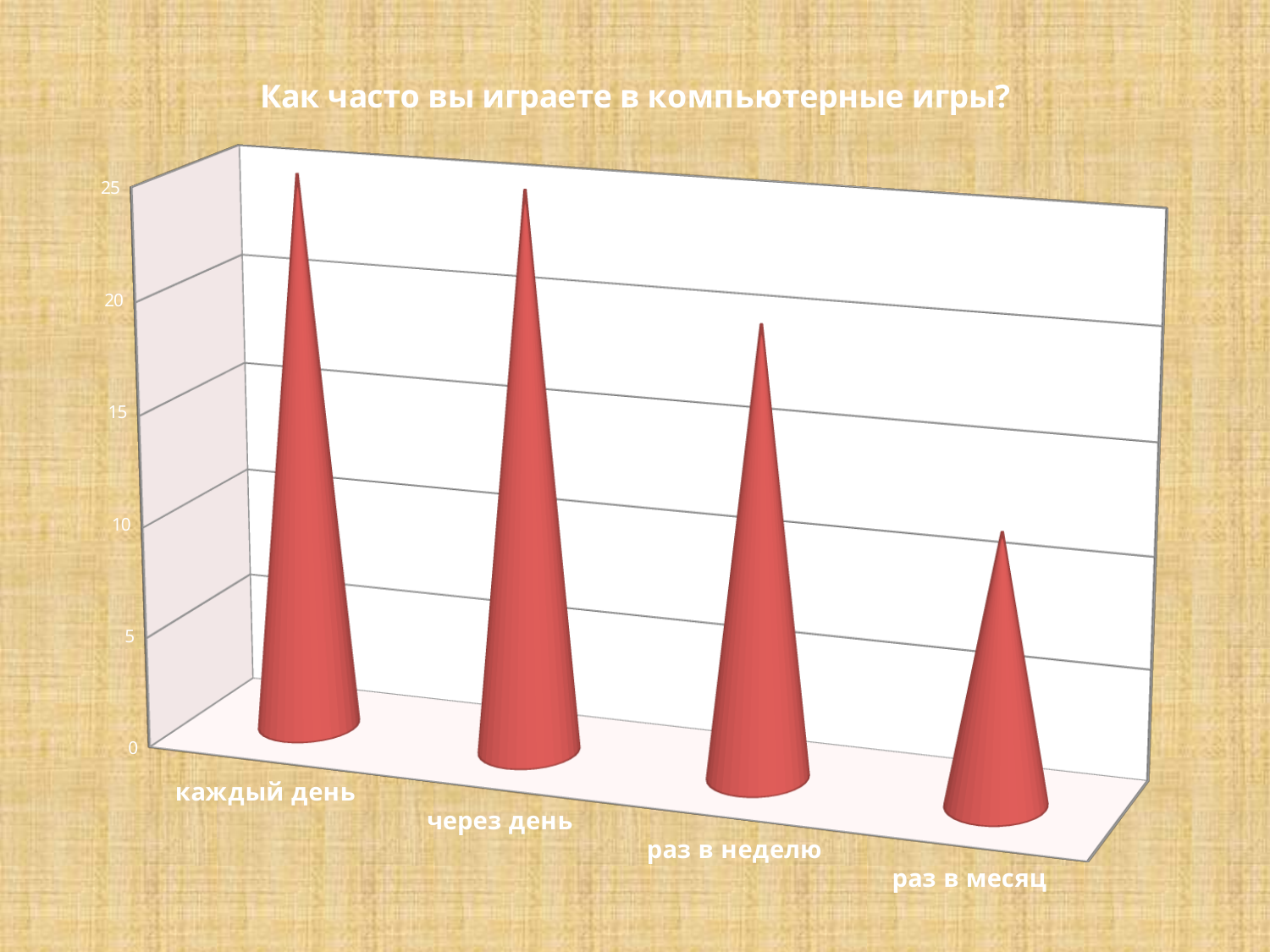
Which is larger, the value for 'каждый день' or the value for 'раз в неделю'? каждый день What is the label of the first category on the left of the chart? каждый день What kind of chart is shown on the slide? bar chart Which category has the lowest value? раз в месяц Is the value for 'каждый день' greater or less than 20? greater Is the value for 'раз в неделю' greater or less than 15? greater How many categories are shown on the chart? 4 Do the values rise or fall from left to right across the categories? fall What is the title of the chart? Как часто вы играете в компьютерные игры? Which is larger, the value for 'раз в неделю' or the value for 'раз в месяц'? раз в неделю Is the value for 'раз в месяц' greater or less than 15? less